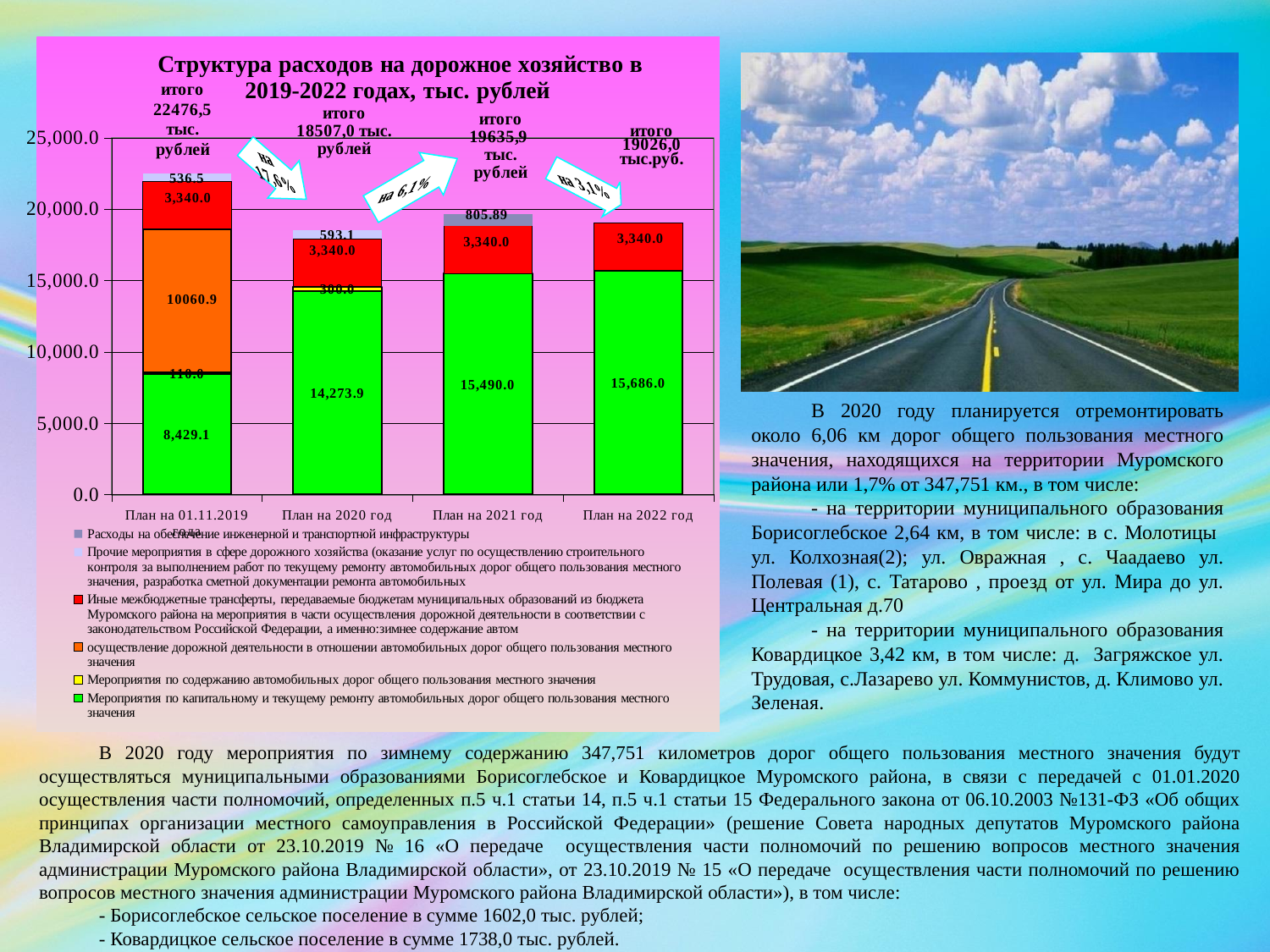
Which category has the highest value for the green segment (Мероприятия по капитальному и текущему ремонту автомобильных дорог)? План на 2022 год Which is larger: the green segment for План на 2021 год or for План на 2020 год? План на 2021 год What kind of chart is shown on the slide? Stacked bar chart How many categories are shown on the x axis of the chart? 4 What is the title of the chart? Структура расходов на дорожное хозяйство в 2019-2022 годах, тыс. рублей How many series does the chart legend list? 6 What is the value of the green segment (Мероприятия по капитальному и текущему ремонту автомобильных дорог) for План на 2020 год? 14,273.9 What is the difference between the green segment values for План на 2022 год and План на 2021 год? 196.0 What total (итого) is annotated above the bar for План на 01.11.2019? 22476,5 тыс. рублей Is the total height of the bar for План на 2020 год greater or less than 20,000.0? less What is the value of the green segment (Мероприятия по капитальному и текущему ремонту автомобильных дорог) for План на 2022 год? 15,686.0 Which category has the lowest value for the green segment (Мероприятия по капитальному и текущему ремонту автомобильных дорог)? План на 01.11.2019